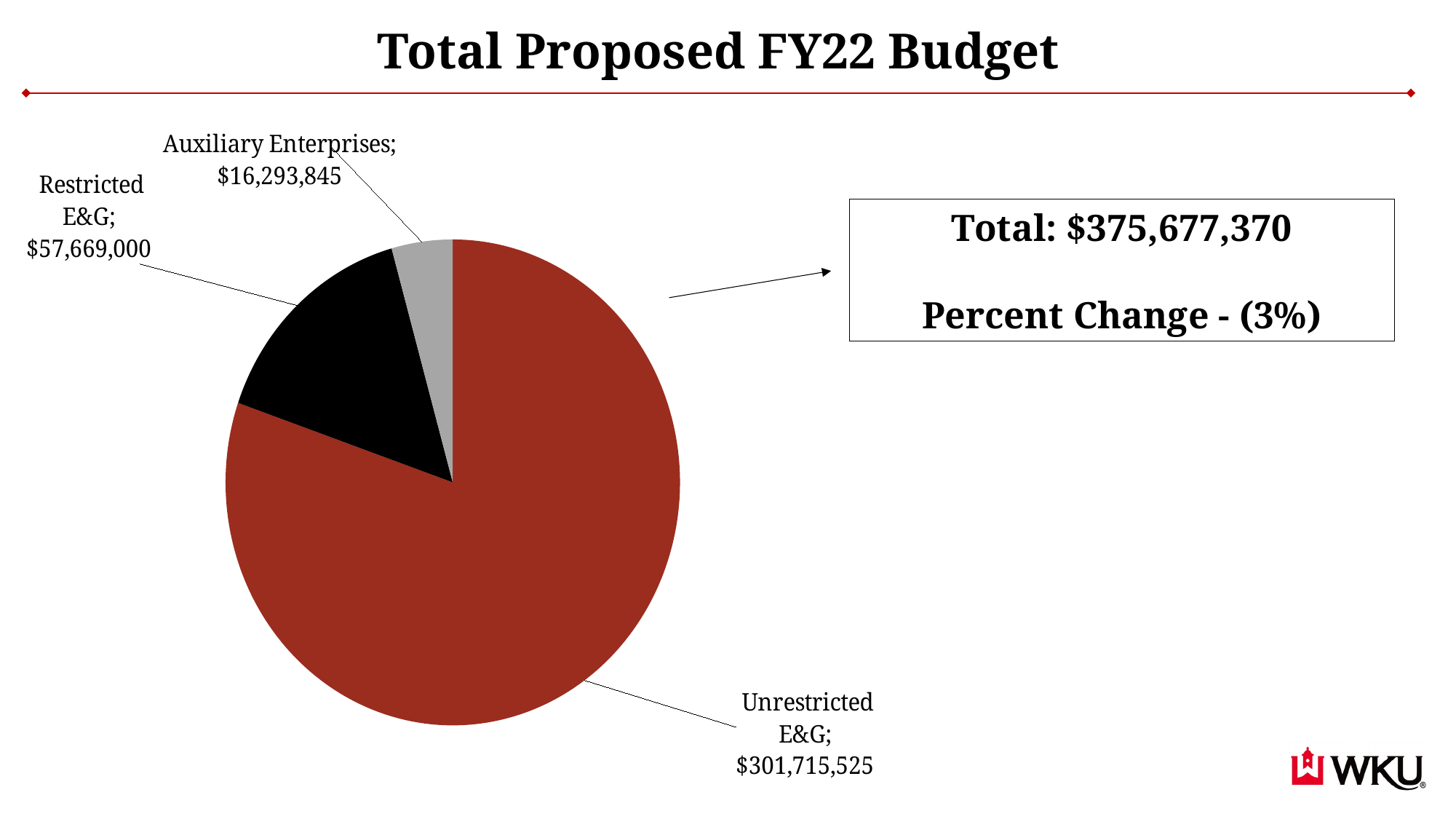
How many slices does the pie chart have? 3 What is the value for Restricted E&G? $57,669,000 What kind of chart is shown on the slide? pie chart What is the value for Auxiliary Enterprises? $16,293,845 Which category has the largest slice of the pie? Unrestricted E&G What is the value for Unrestricted E&G? $301,715,525 What total budget is stated in the box next to the pie chart? $375,677,370 What is the difference between Restricted E&G and Auxiliary Enterprises? $41,375,155 Which category has the smallest slice of the pie? Auxiliary Enterprises What percent change is stated in the box next to the pie chart? (3%) What is the difference between Unrestricted E&G and Restricted E&G? $244,046,525 Which is larger, Restricted E&G or Auxiliary Enterprises? Restricted E&G